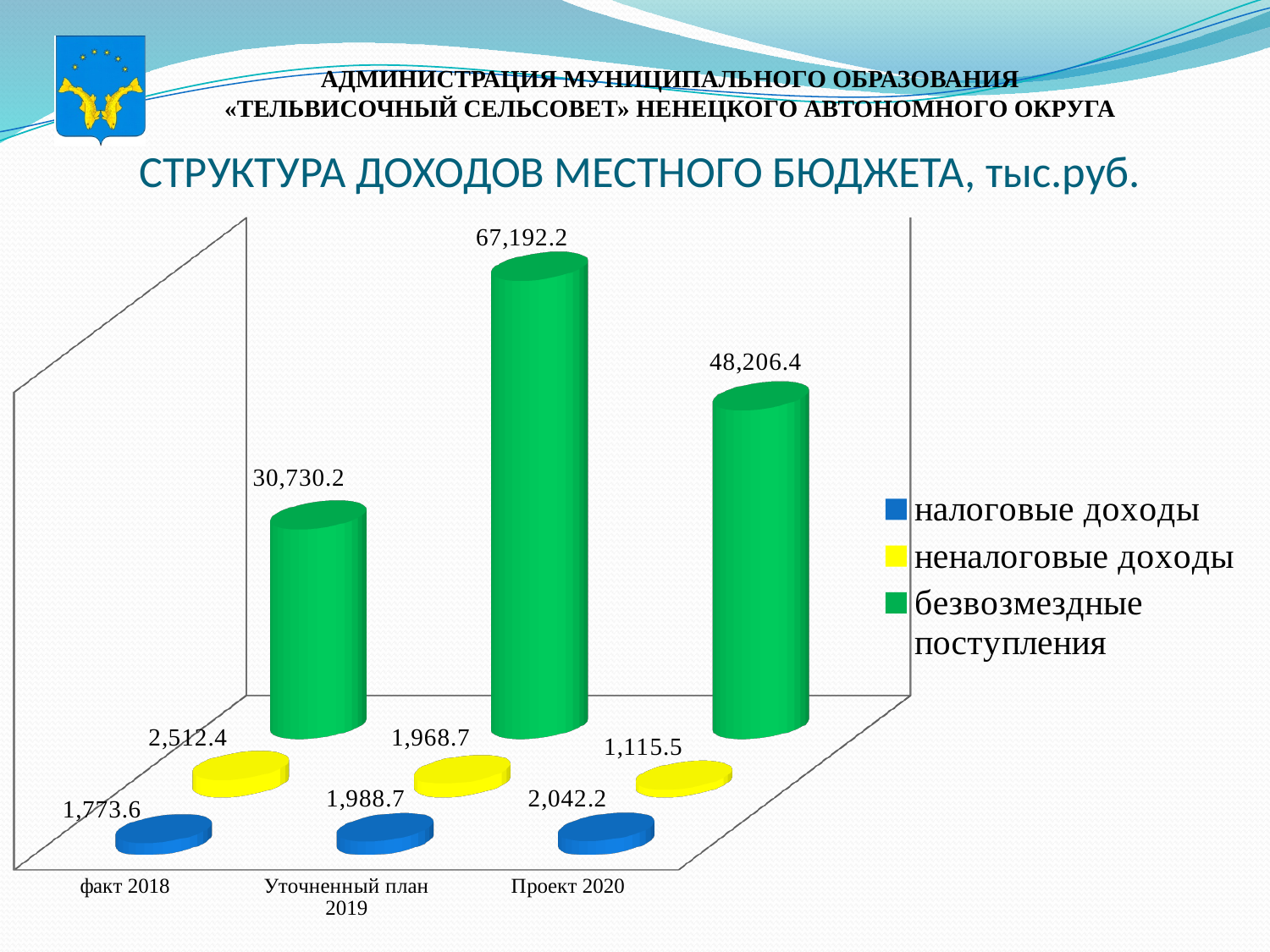
What kind of chart is shown on the slide? Bar chart What is the value of налоговые доходы for факт 2018? 1,773.6 Which category has the lowest value for неналоговые доходы? Проект 2020 Do the values for неналоговые доходы rise or fall from факт 2018 to Проект 2020? Fall What is the value of неналоговые доходы for Проект 2020? 1,115.5 What is the value of безвозмездные поступления for Проект 2020? 48,206.4 What is the difference between безвозмездные поступления for Уточненный план 2019 and факт 2018? 36,462.0 What is the value of безвозмездные поступления for Уточненный план 2019? 67,192.2 Which is larger: налоговые доходы for Проект 2020 or налоговые доходы for Уточненный план 2019? Проект 2020 How many categories are shown on the x axis? 3 How many series does the legend list? 3 Which category has the highest value for безвозмездные поступления? Уточненный план 2019